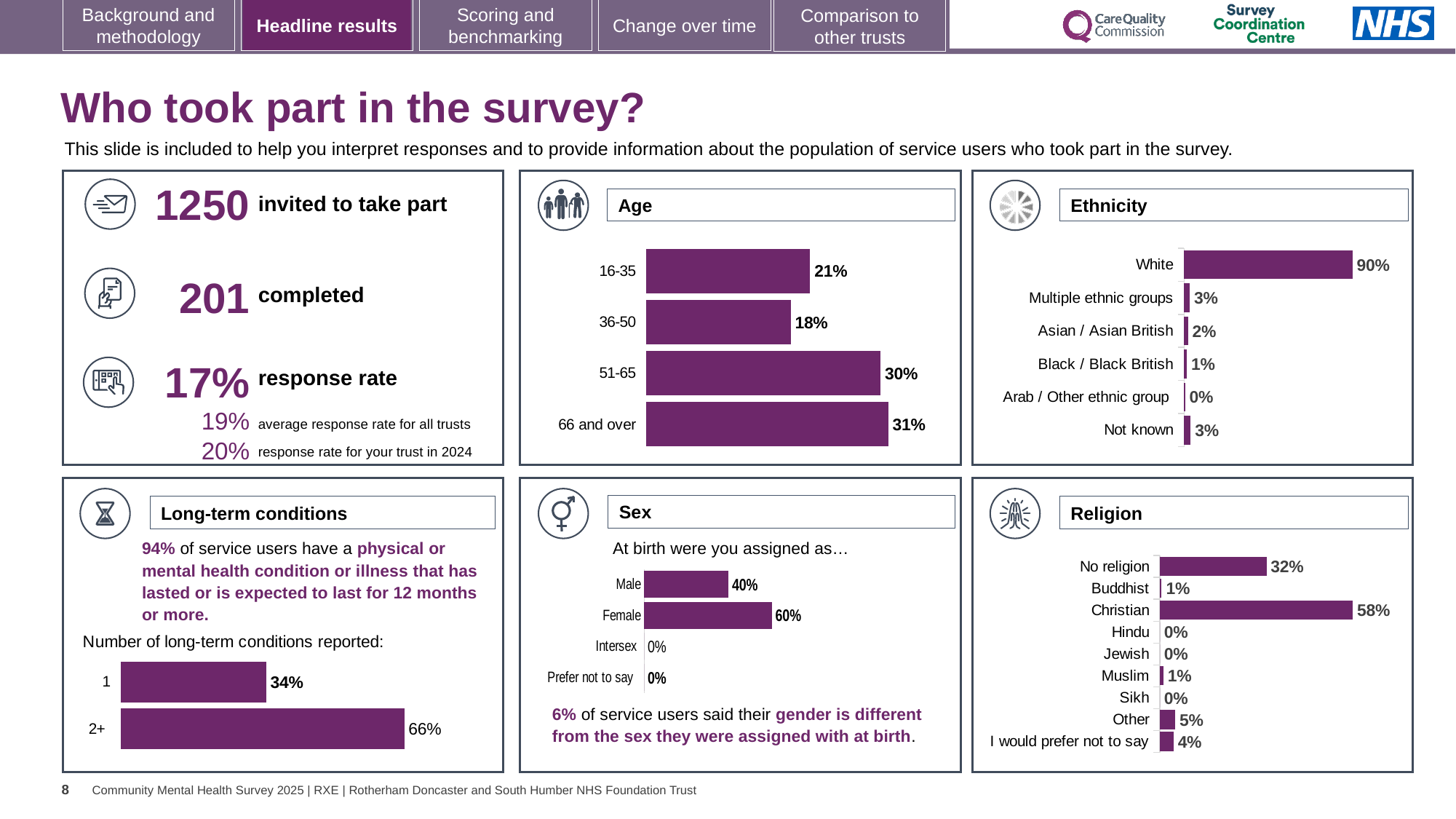
In the Age chart, which age group has the lowest percentage? 36-50 In the Sex chart, what percentage of respondents were assigned Female at birth? 60% In the Ethnicity chart, how many ethnicity categories are shown? 6 In the Religion chart, which religion category has the highest percentage? Christian In the Sex chart, what is the difference between the Female and Male percentages? 20% What type of chart is used in the Age panel? Bar chart In the Age chart, what is the difference between the 51-65 and 16-35 percentages? 9% In the Ethnicity chart, which is larger, Multiple ethnic groups or Black / Black British? Multiple ethnic groups In the Age chart, what percentage of respondents were aged 66 and over? 31% In the Ethnicity chart, what percentage of respondents were White? 90% In the Long-term conditions chart, what percentage of respondents reported 2+ long-term conditions? 66% In the Religion chart, what percentage of respondents reported No religion? 32%